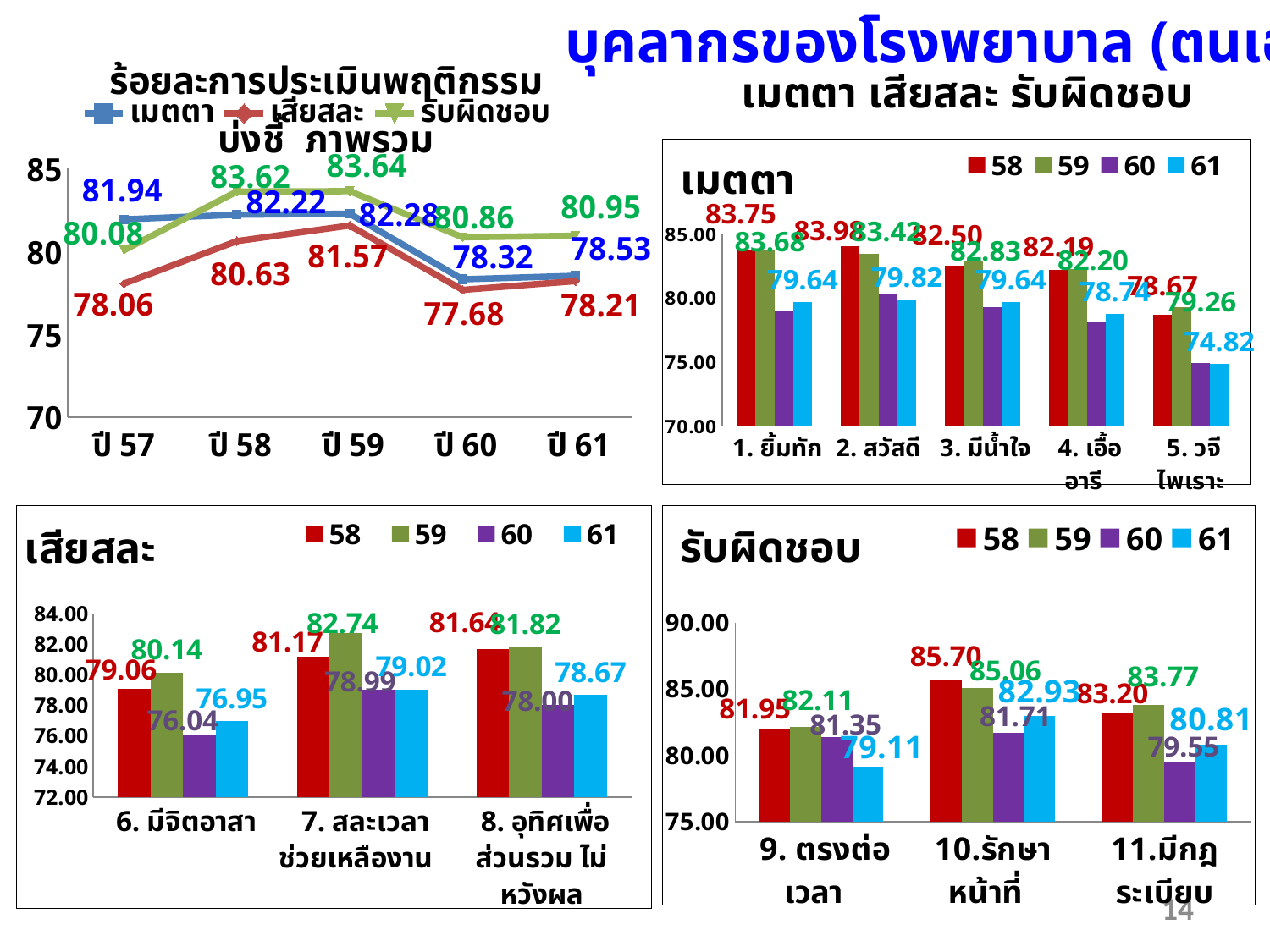
In the line chart titled ร้อยละการประเมินพฤติกรรม บ่งชี้ ภาพรวม, in which year is รับผิดชอบ highest? ปี 59 In the bar chart titled เมตตา, how many categories are shown on the x axis? 5 In the line chart titled ร้อยละการประเมินพฤติกรรม บ่งชี้ ภาพรวม, what is the value of เมตตา for ปี 57? 81.94 In the line chart titled ร้อยละการประเมินพฤติกรรม บ่งชี้ ภาพรวม, how many series does the legend list? 3 In the bar chart titled รับผิดชอบ, what is the value of series 58 for 10.รักษาหน้าที่? 85.70 In the bar chart titled เมตตา, what is the value of series 61 for 5. วจีไพเราะ? 74.82 In the line chart titled ร้อยละการประเมินพฤติกรรม บ่งชี้ ภาพรวม, what is the value of เสียสละ for ปี 60? 77.68 In the line chart titled ร้อยละการประเมินพฤติกรรม บ่งชี้ ภาพรวม, what is the difference between รับผิดชอบ and เสียสละ in ปี 58? 2.99 In the bar chart titled รับผิดชอบ, is the value of series 61 for 9. ตรงต่อเวลา greater or less than 80.00? less In the bar chart titled เสียสละ, what is the value of series 60 for 6. มีจิตอาสา? 76.04 What type of chart is the chart titled รับผิดชอบ? bar chart In the bar chart titled เสียสละ, which series has the highest value for 7. สละเวลาช่วยเหลืองาน? 59